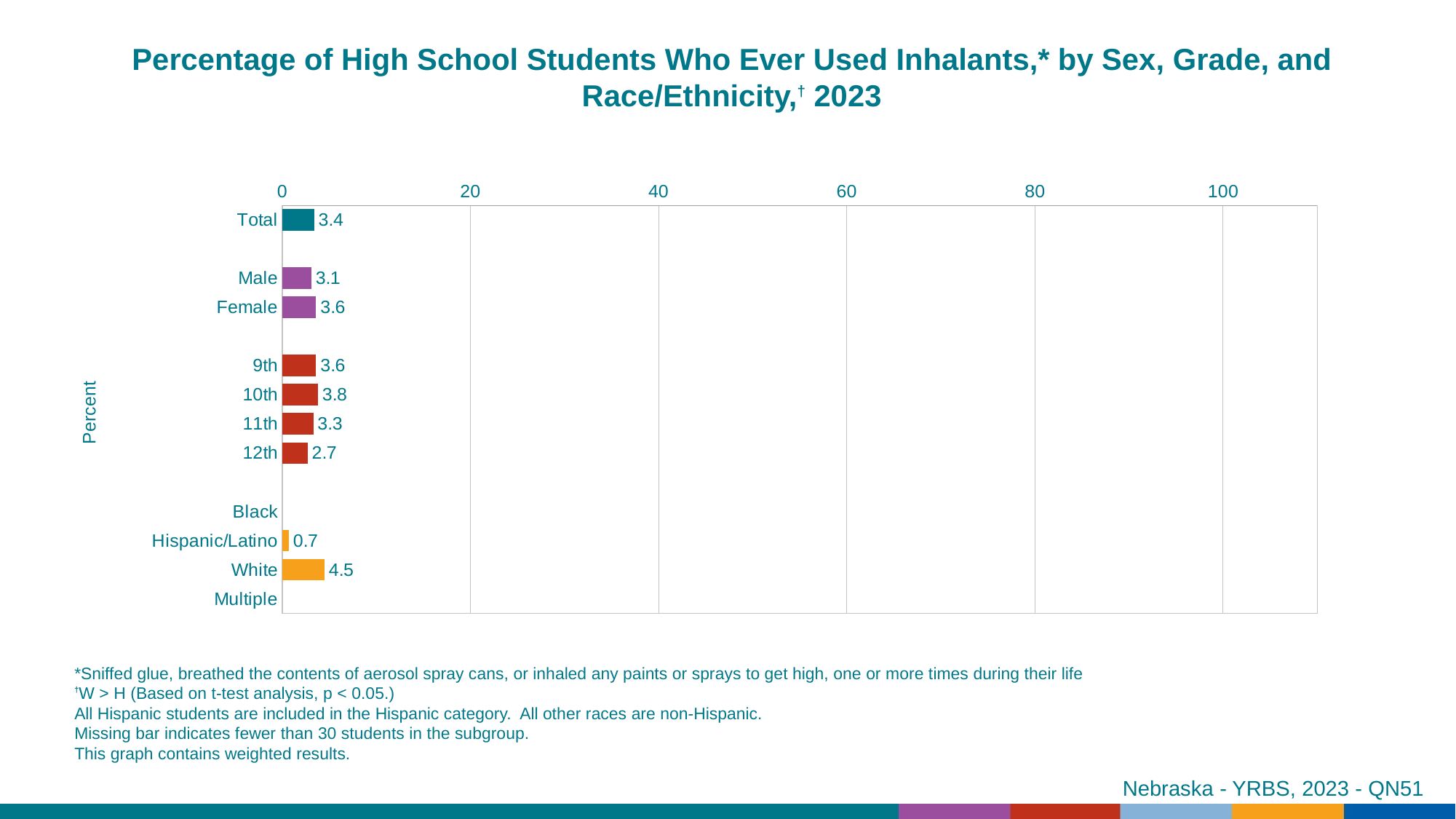
What is the difference between the values for White and Hispanic/Latino? 3.8 What is the difference between the values for Female and Male? 0.5 Is the value for White greater or less than 20? less What kind of chart is shown on the slide? bar chart What is the value for Hispanic/Latino? 0.7 What is the value for Total? 3.4 Which categories have no bar plotted? Black and Multiple What is the value for 12th grade? 2.7 Which category has the highest value? White Which category with a plotted bar has the lowest value? Hispanic/Latino What is the value for Female? 3.6 Which is larger, the value for 10th grade or 11th grade? 10th